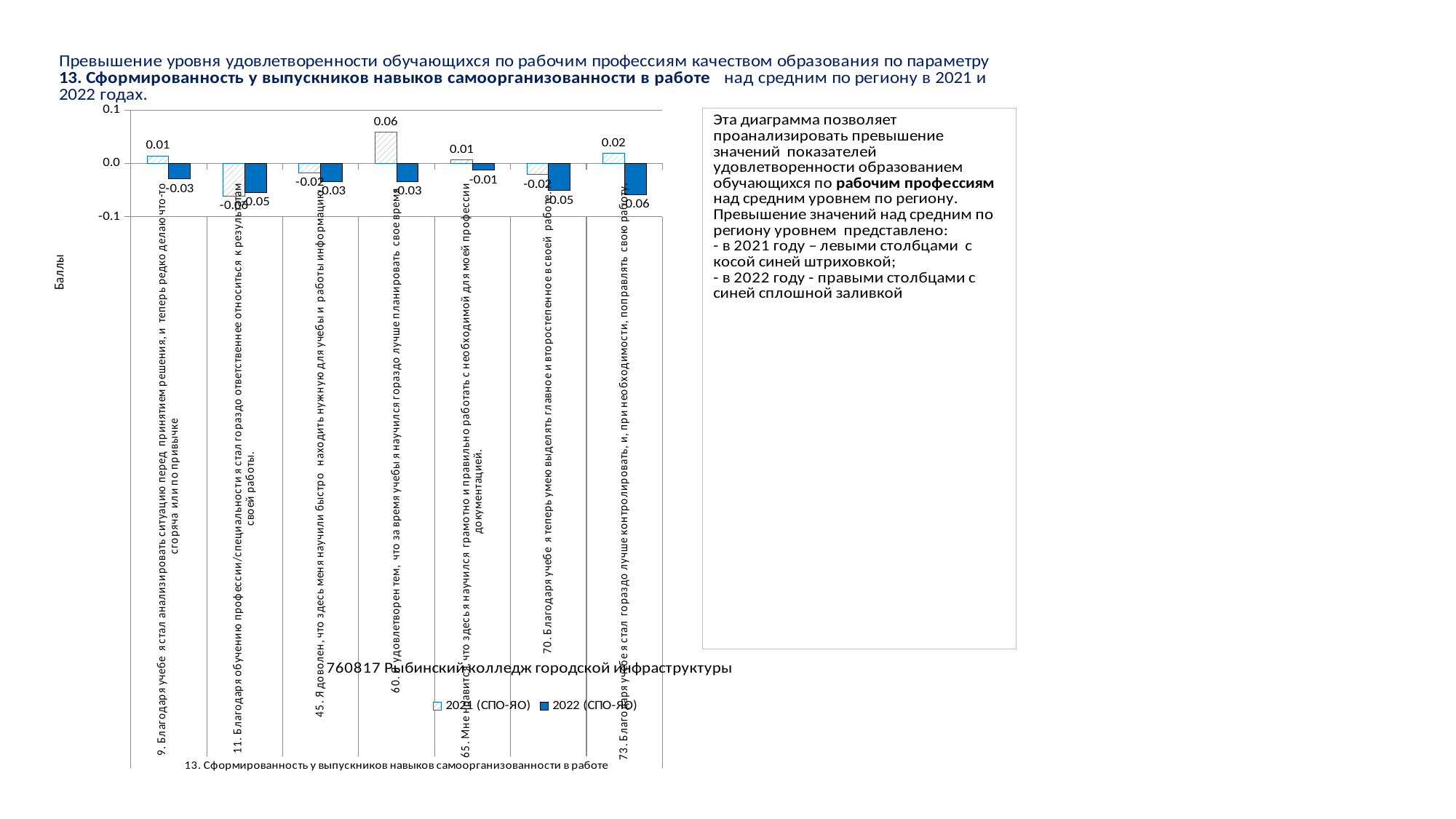
What is the 2021 (СПО-ЯО) value for statement 60 ("Я удовлетворен тем, что за время учебы я научился гораздо лучше планировать свое время")? 0.06 For statement 60, what is the difference between the 2021 (СПО-ЯО) value and the 2022 (СПО-ЯО) value? 0.09 How many statements have a positive 2021 (СПО-ЯО) value? 4 What is the 2022 (СПО-ЯО) value for statement 73 ("Благодаря учебе я стал гораздо лучше контролировать... свою работу")? -0.06 What is the 2022 (СПО-ЯО) value for statement 70 ("Благодаря учебе я теперь умею выделять главное и второстепенное в своей работе")? -0.05 What are the two legend entries of the chart? 2021 (СПО-ЯО) and 2022 (СПО-ЯО) How many series does the chart legend list? 2 Which statement has the lowest 2022 (СПО-ЯО) value? 73. Благодаря учебе я стал гораздо лучше контролировать, и, при необходимости, поправлять свою работу What kind of chart is shown on the slide? bar chart Which statement has the highest 2021 (СПО-ЯО) value? 60. Я удовлетворен тем, что за время учебы я научился гораздо лучше планировать свое время Which is larger: the 2022 (СПО-ЯО) value for statement 9 or the 2022 (СПО-ЯО) value for statement 65? statement 65 (-0.01) How many categories (survey statements) are plotted on the x axis? 7